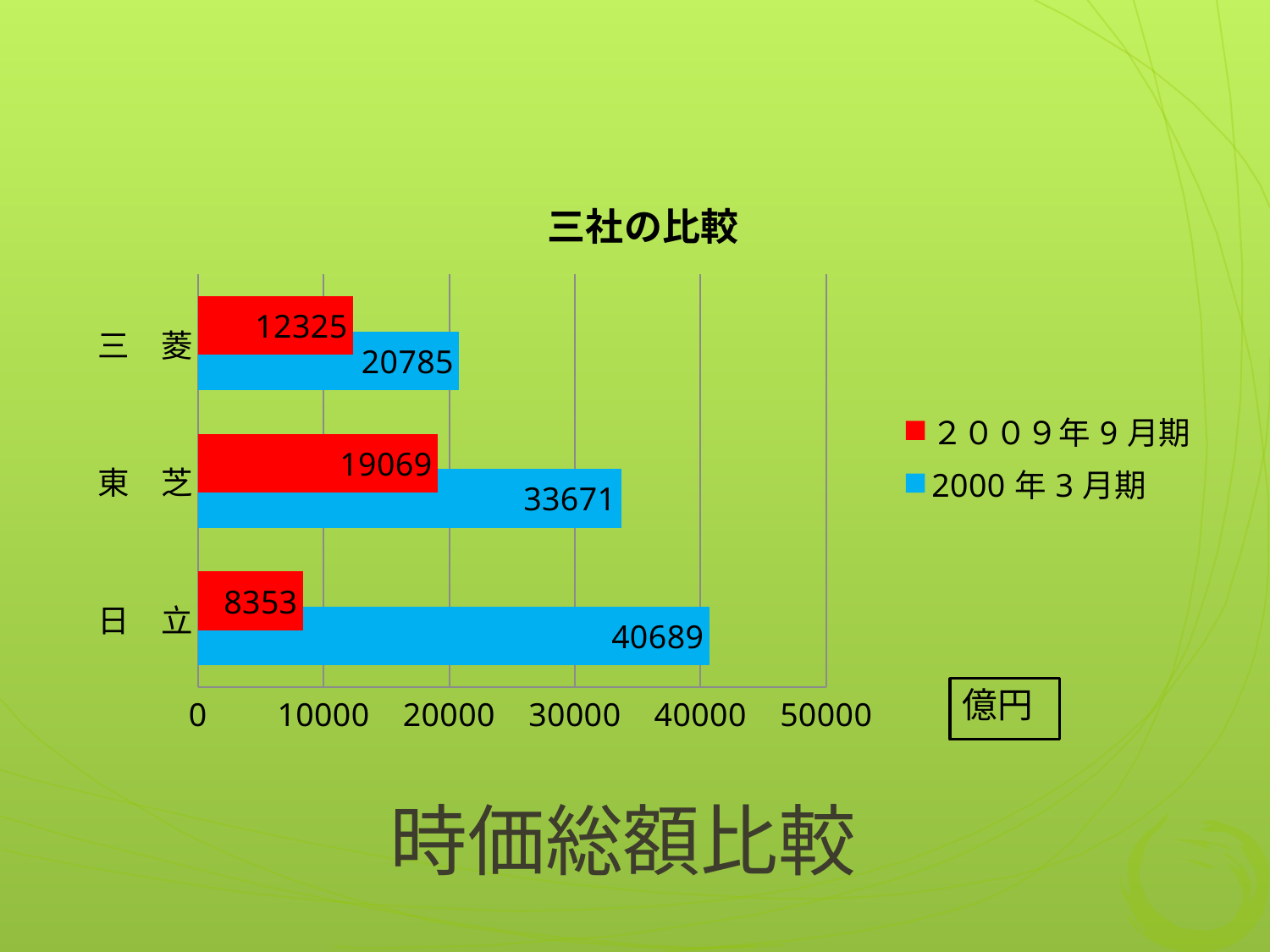
What is the difference between the 2000年３月期 and ２００９年９月期 values for 日立? 32336 How many series does the legend list? 2 Which company has the highest value in the 2000年３月期 series? 日立 Which company has the lowest value in the ２００９年９月期 series? 日立 What is the value for 日立 in the 2000年３月期 series? 40689 What type of chart is shown on the slide? bar chart Which colour represents the 2000年３月期 series? blue Which is larger: the ２００９年９月期 value for 東芝 or the ２００９年９月期 value for 三菱? 東芝 What is the value for 三菱 in the ２００９年９月期 series? 12325 What is the chart's title? 三社の比較 What is the value for 東芝 in the 2000年３月期 series? 33671 How many companies are shown on the chart? 3